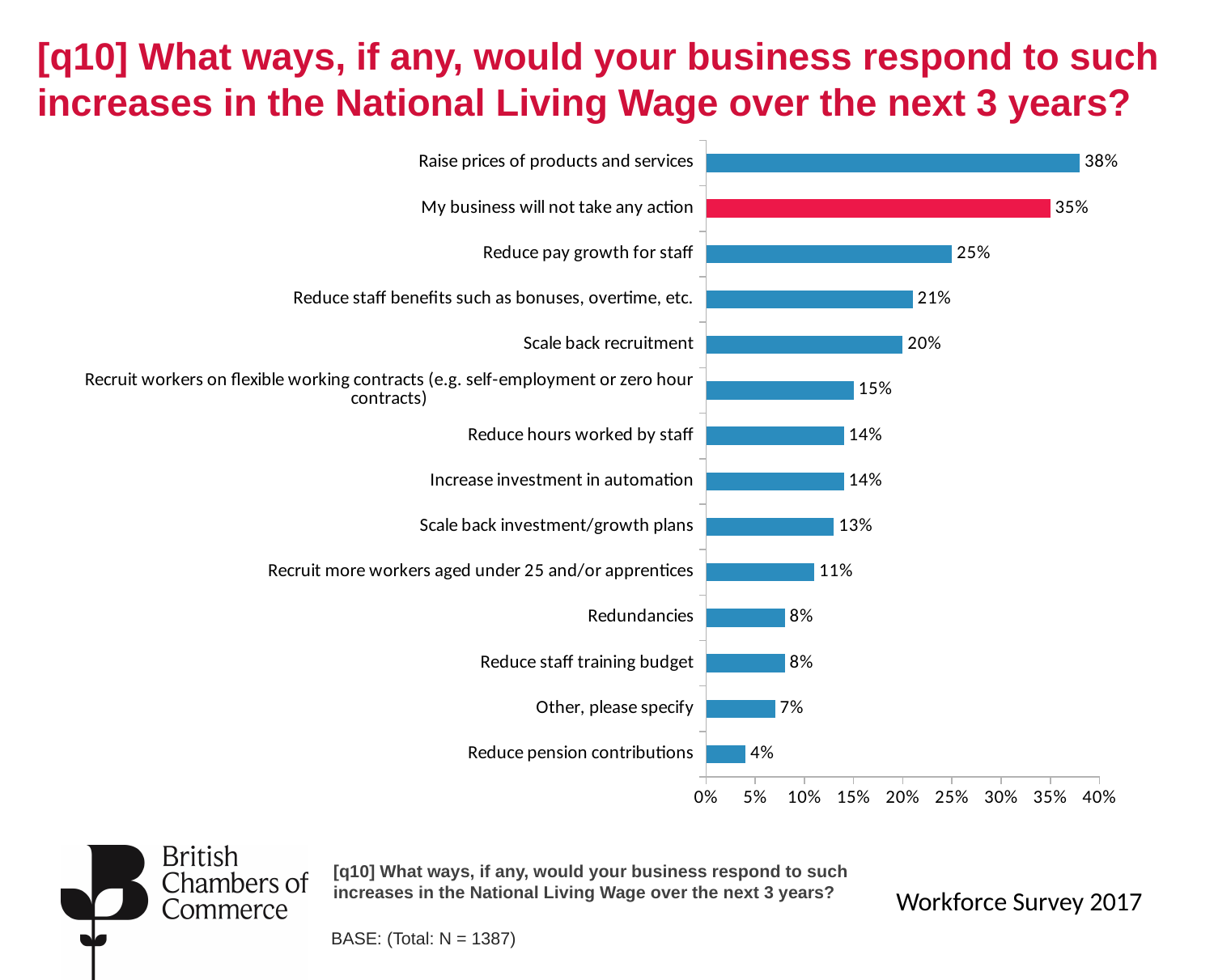
Which is larger: "Scale back recruitment" or "Scale back investment/growth plans"? Scale back recruitment What percentage of businesses said they would raise prices of products and services? 38% What percentage of businesses said they would scale back recruitment? 20% Which bar is shown in a different colour (red) from the others? My business will not take any action What kind of chart is shown on the slide? Bar chart What is the value for "Reduce pension contributions"? 4% What is the difference between "Raise prices of products and services" and "My business will not take any action"? 3 percentage points What is the value for "My business will not take any action"? 35% Which response has the lowest percentage? Reduce pension contributions Which response has the highest percentage? Raise prices of products and services How many response categories are shown in the chart? 14 What is the difference between "Reduce pay growth for staff" and "Reduce staff benefits such as bonuses, overtime, etc."? 4 percentage points